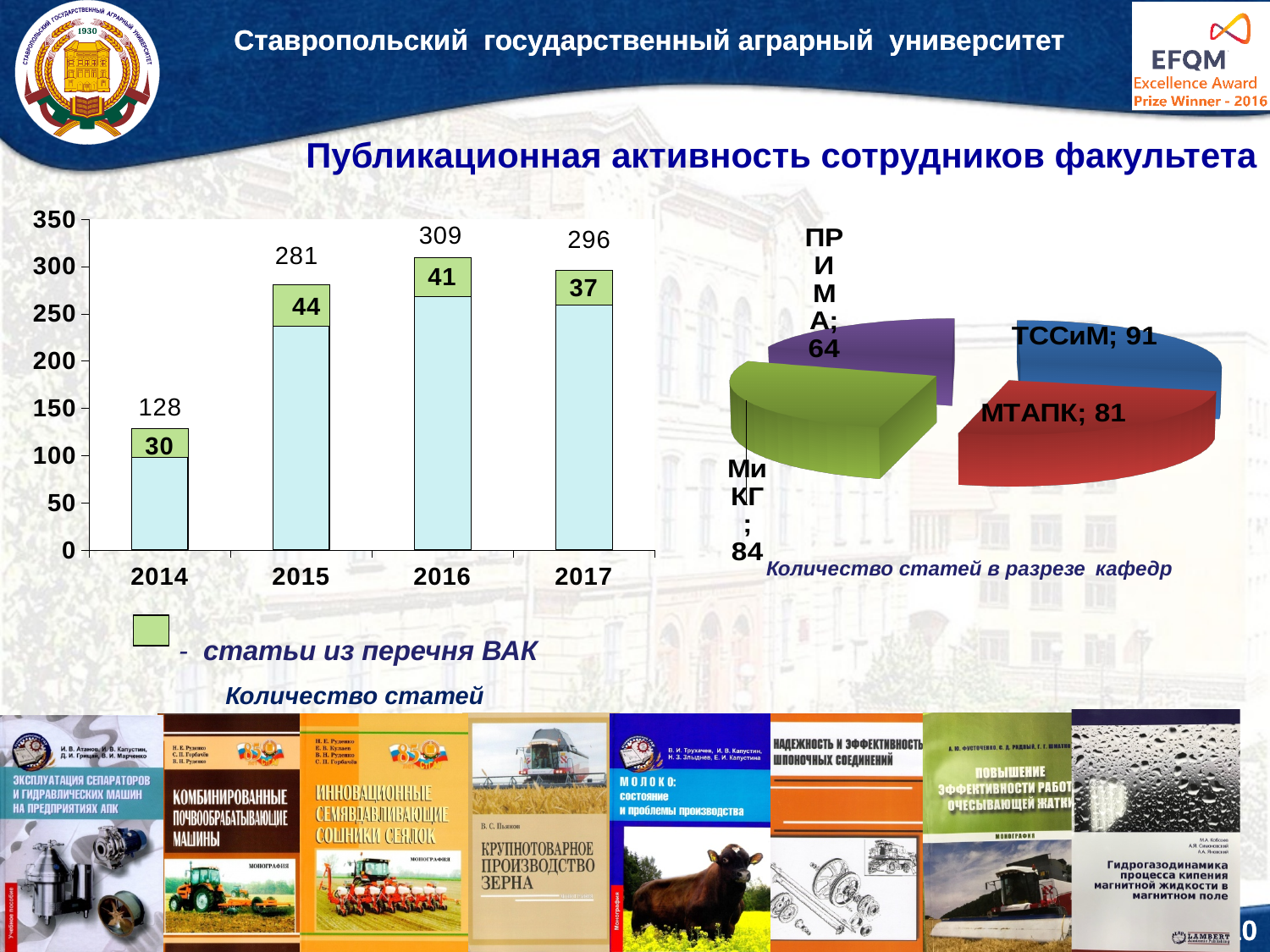
In the pie chart on the right, which has more articles, МиКГ or ПРИМА? МиКГ In the bar chart on the left, is the total for 2017 greater or less than 250? greater In the bar chart on the left, what is the difference between the total number of articles in 2015 and 2014? 153 In the bar chart on the left, what is the total number of articles for 2016? 309 In the pie chart on the right, which department has the largest number of articles? ТССиМ What type of chart is shown on the left side of the slide? bar chart In the bar chart on the left, how many years are shown on the x axis? 4 In the pie chart on the right, how many departments are shown? 4 In the bar chart on the left, which year has the lowest total number of articles? 2014 In the bar chart on the left, which year has the highest total number of articles? 2016 In the pie chart on the right, how many articles does the МТАПК department have? 81 In the bar chart on the left, how many articles from the VAK list (green segment) were there in 2015? 44